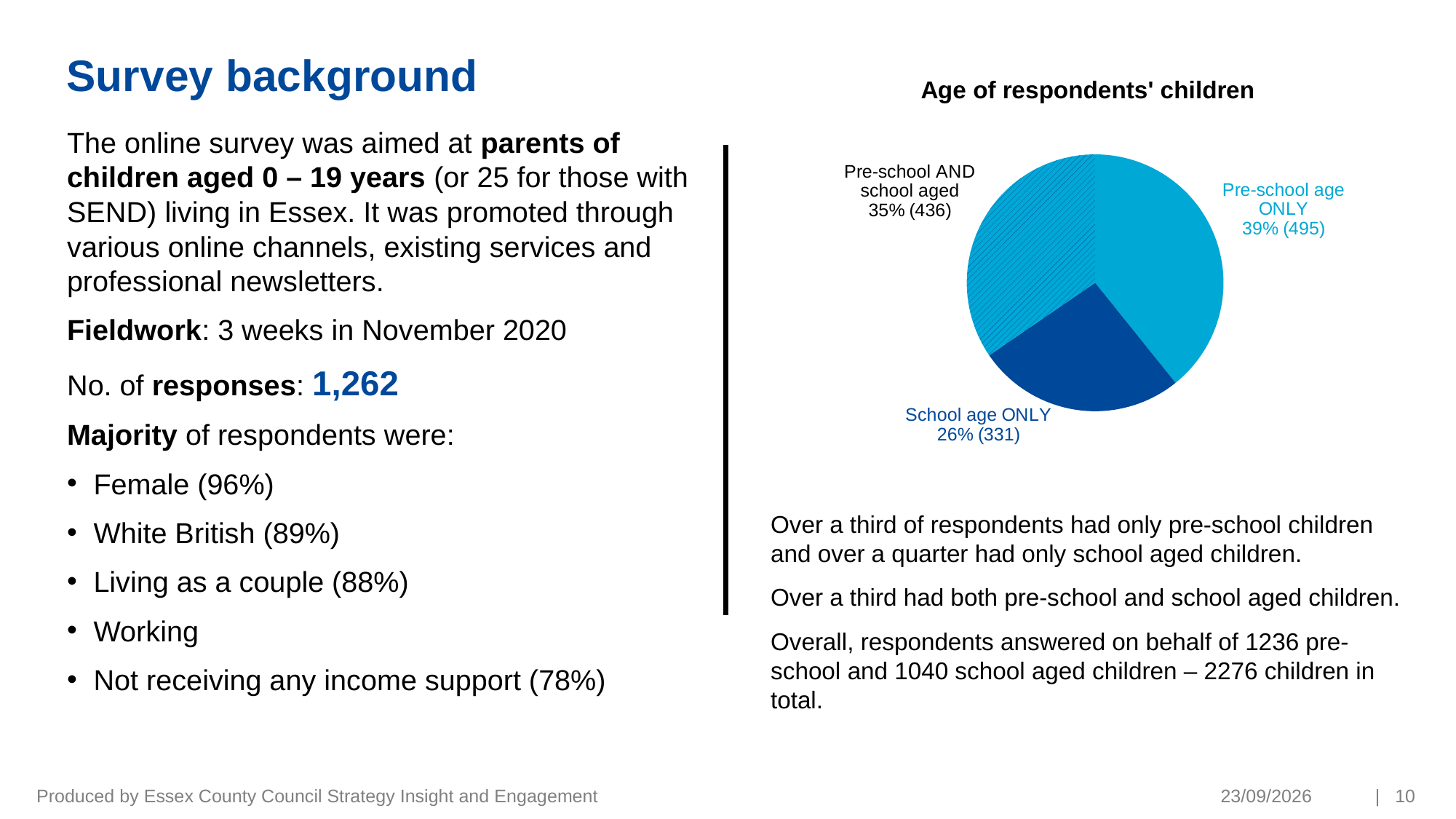
What percentage of respondents had both pre-school and school aged children? 35% What is the difference in number of respondents between Pre-school age ONLY and School age ONLY? 164 What percentage of respondents had pre-school age children only? 39% Which category has the largest share of the pie? Pre-school age ONLY How many categories does the pie chart show? 3 How many respondents had both pre-school and school aged children? 436 Which is larger: the share for School age ONLY or the share for Pre-school AND school aged? Pre-school AND school aged What kind of chart is shown on the slide? Pie chart Which category has the smallest share of the pie? School age ONLY What is the title of the chart? Age of respondents' children What is the total number of respondents across the three slices of the pie? 1,262 How many respondents had school age children only? 331